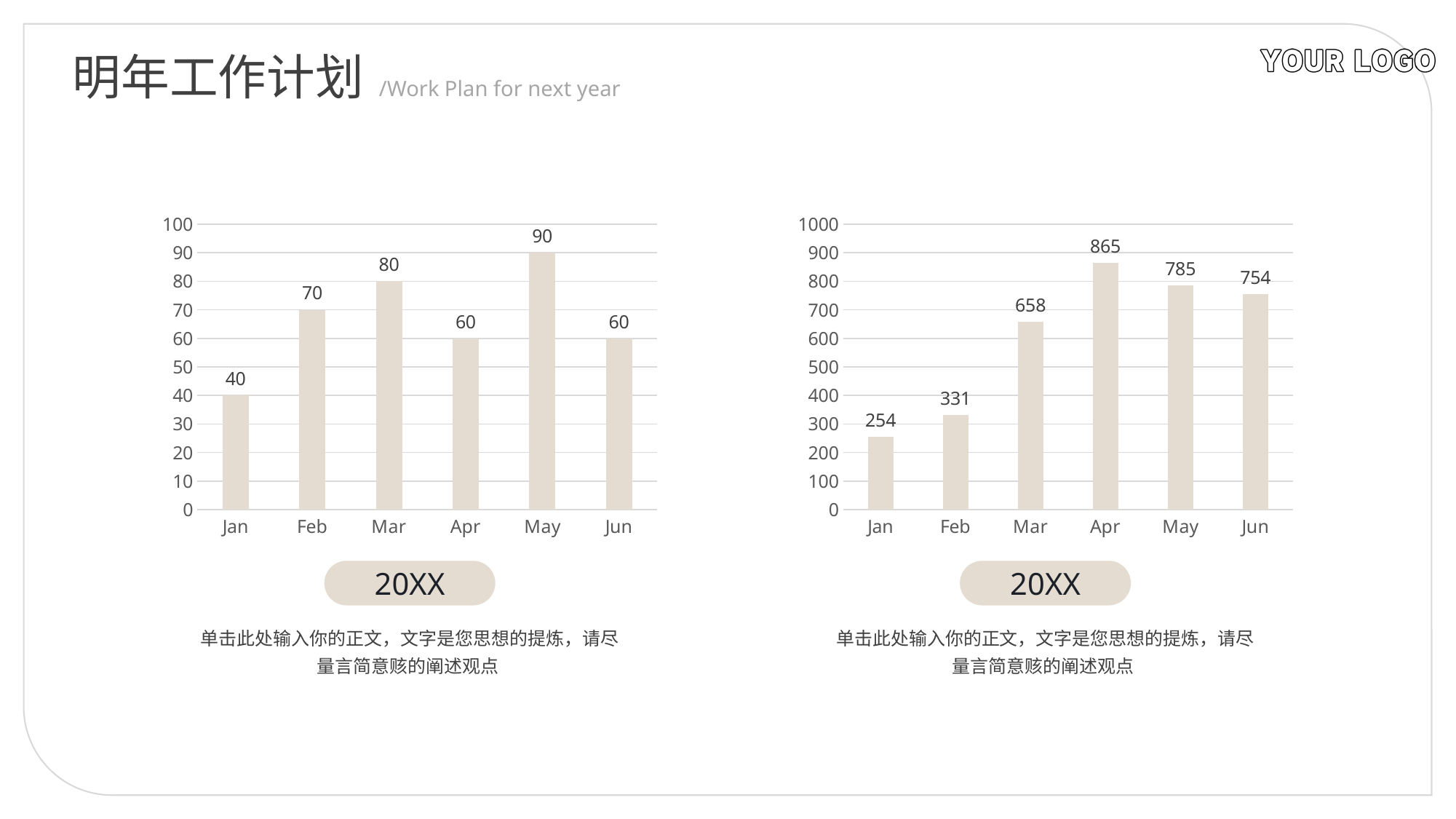
In the left chart, what is the value for Mar? 80 In the right chart, which month has the lowest value? Jan In the left chart, which month has the highest value? May In the right chart, which is larger, the value for May or the value for Jun? May In the right chart, do the values rise or fall from Jan to Apr? Rise In the left chart, which month has the lowest value? Jan In the right chart, what is the difference between the values for Apr and Mar? 207 In the right chart, what is the value for Feb? 331 In the left chart, what is the difference between the values for May and Jan? 50 In the left chart, how many months are shown on the x axis? 6 What kind of chart is the right chart? Bar chart In the right chart, which month has the highest value? Apr